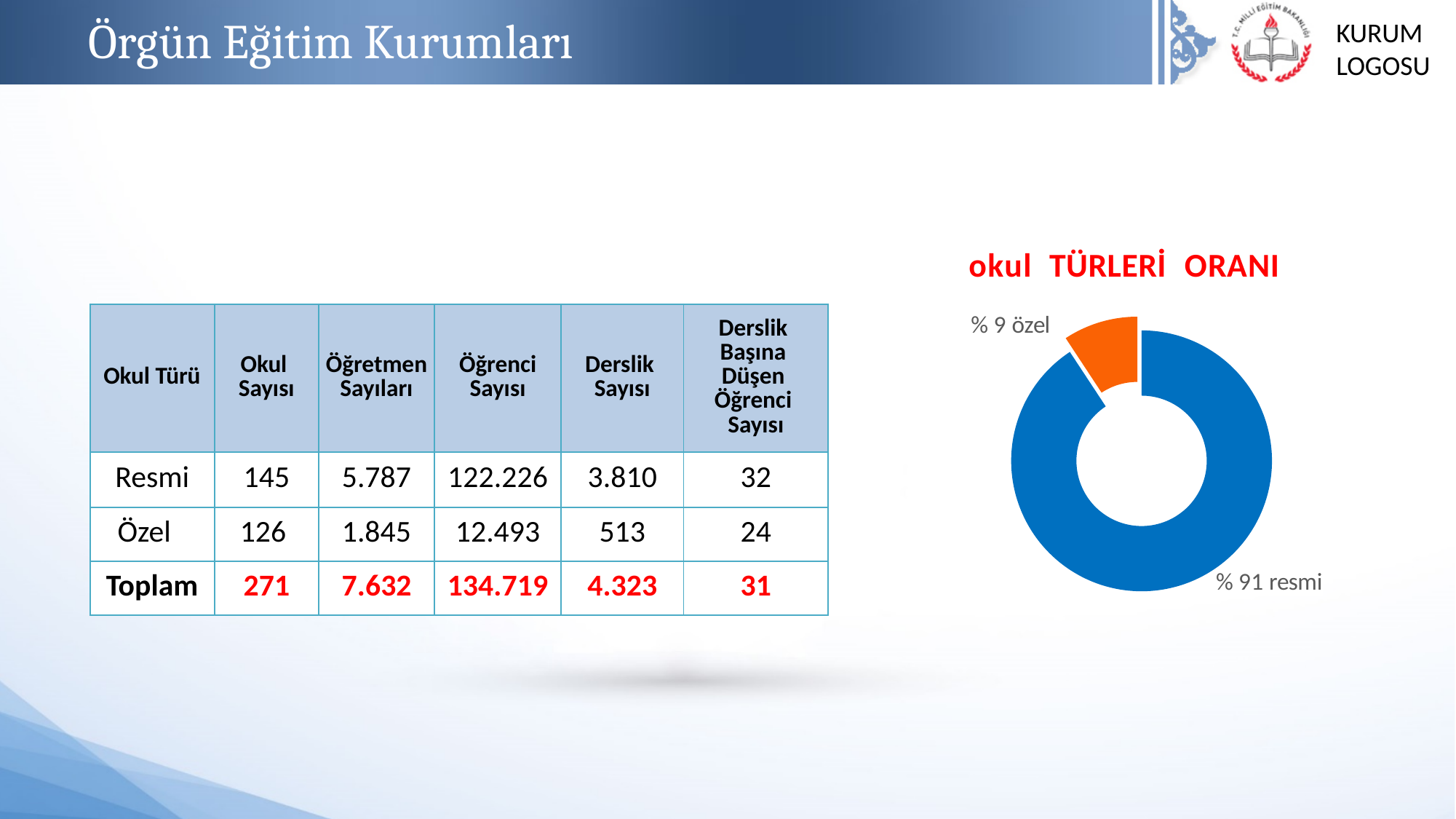
What is the difference in percentage points between the resmi and özel slices? 82 Which slice of the chart is the smallest? özel How many slices does the chart have? 2 Which slice of the chart is the largest? resmi What kind of chart is shown on the slide? doughnut chart Which is larger in the chart, the resmi slice or the özel slice? resmi What share of the chart does the özel slice represent? % 9 What colour is the özel slice in the chart? orange What share of the chart does the resmi slice represent? % 91 What is the title of the chart on the slide? okul TÜRLERİ ORANI